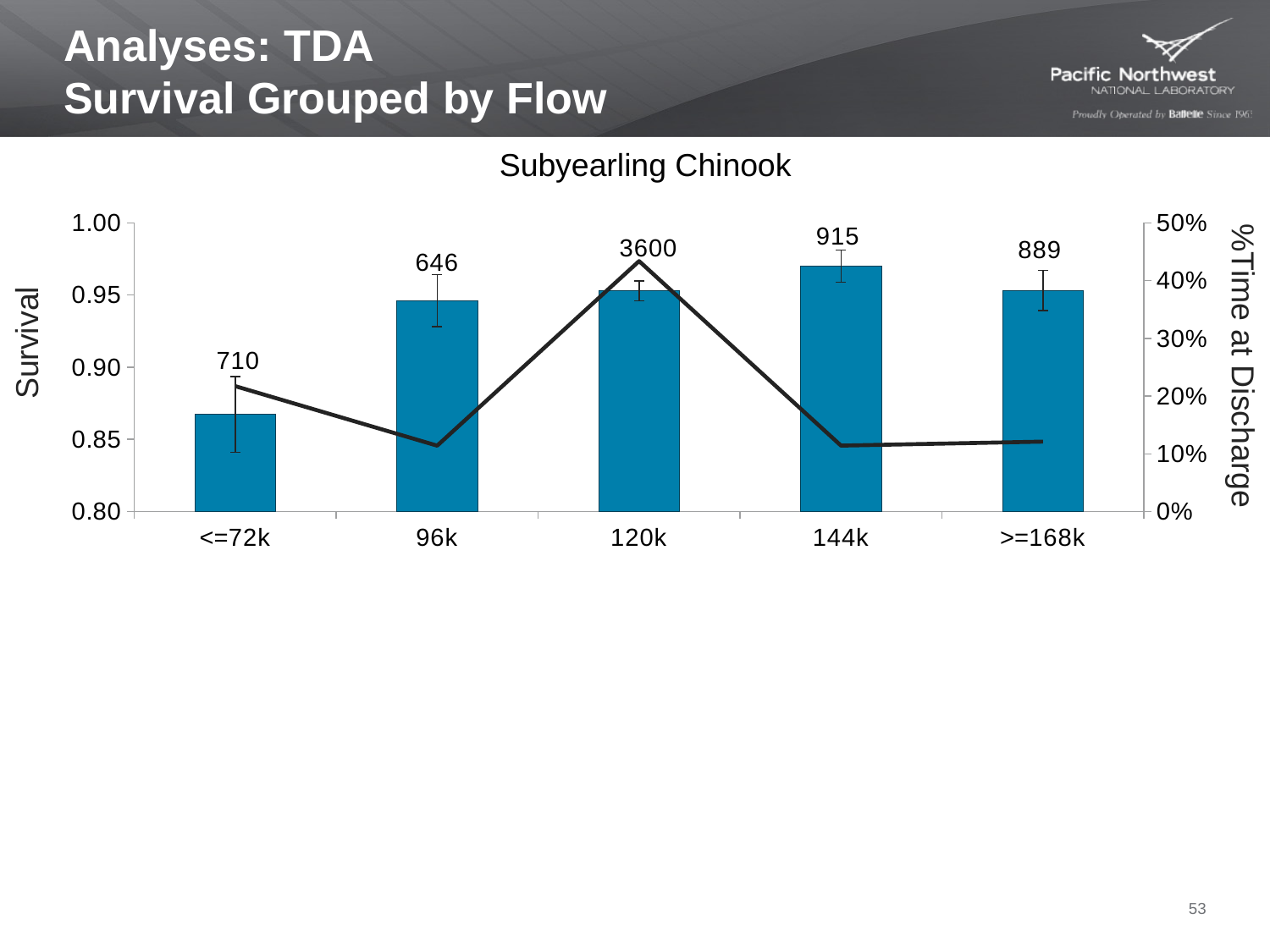
Is the Survival value for 144k greater or less than 0.95? greater At which flow category does the %Time at Discharge line reach its highest point? 120k How many flow categories are shown on the x axis? 5 What is the title of the chart? Subyearling Chinook What number is printed above the bar for >=168k? 889 Is the Survival value for <=72k greater or less than 0.90? less Which flow category has the highest Survival bar? 144k Which flow category has the lowest Survival bar? <=72k What number is printed above the bar for <=72k? 710 What kind of chart is used to show Survival? bar chart Is the %Time at Discharge value for 96k greater or less than 20%? less What number is printed above the bar for 120k? 3600